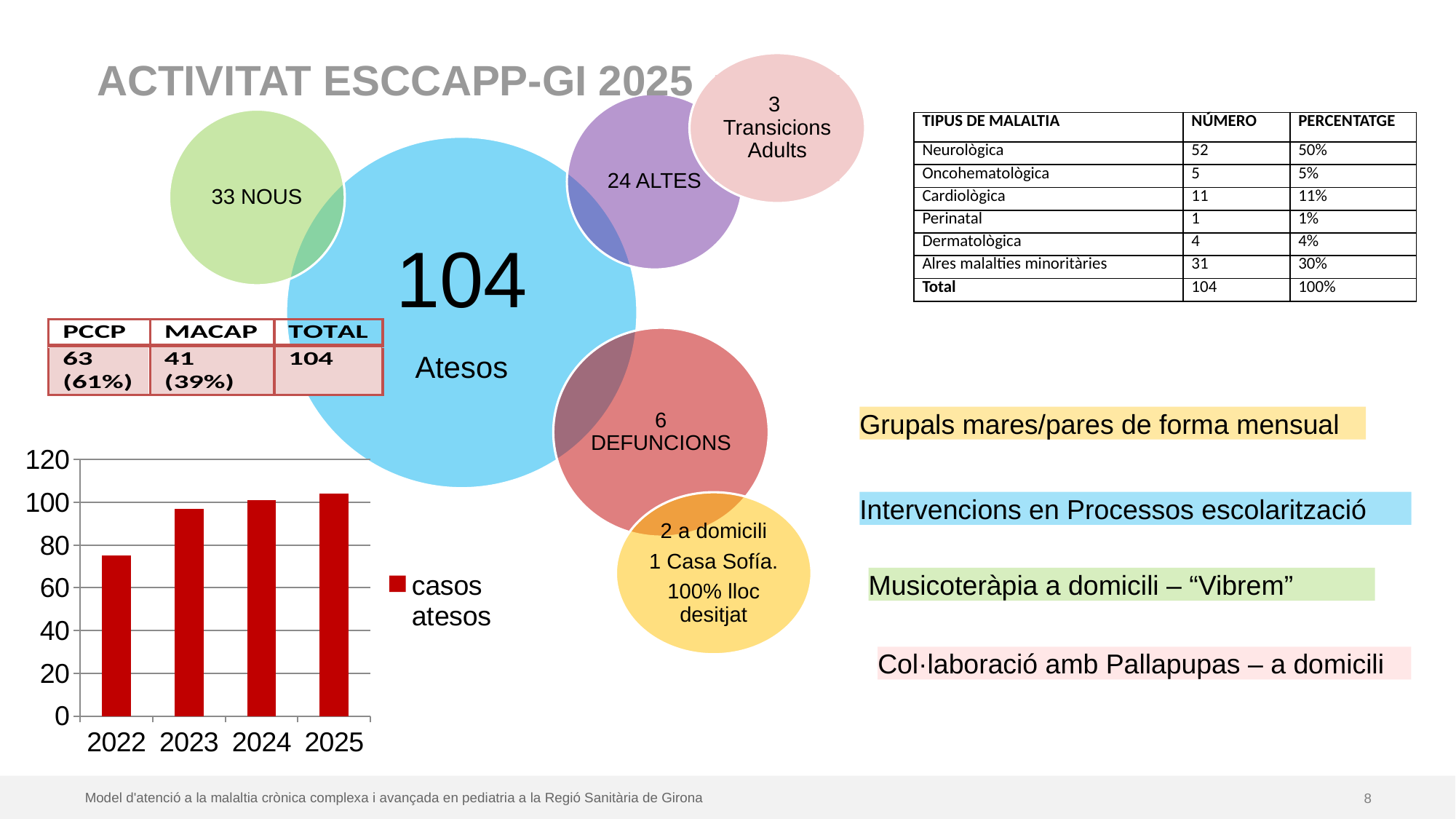
In the bar chart, is the value for 2022 greater or less than 80? less Which year has the lowest value in the bar chart? 2022 In the bar chart, which year has the larger value, 2022 or 2023? 2023 How many years are shown on the x axis of the bar chart? 4 What is the name of the series shown in the bar chart legend? casos atesos In the bar chart, is the value for 2025 greater or less than 100? greater What colour are the bars in the bar chart? red In the bar chart, is the value for 2023 greater or less than 80? greater How many series does the legend of the bar chart list? 1 What kind of chart is shown at the bottom left of the slide? bar chart Do the values in the bar chart rise or fall from 2022 to 2025? rise